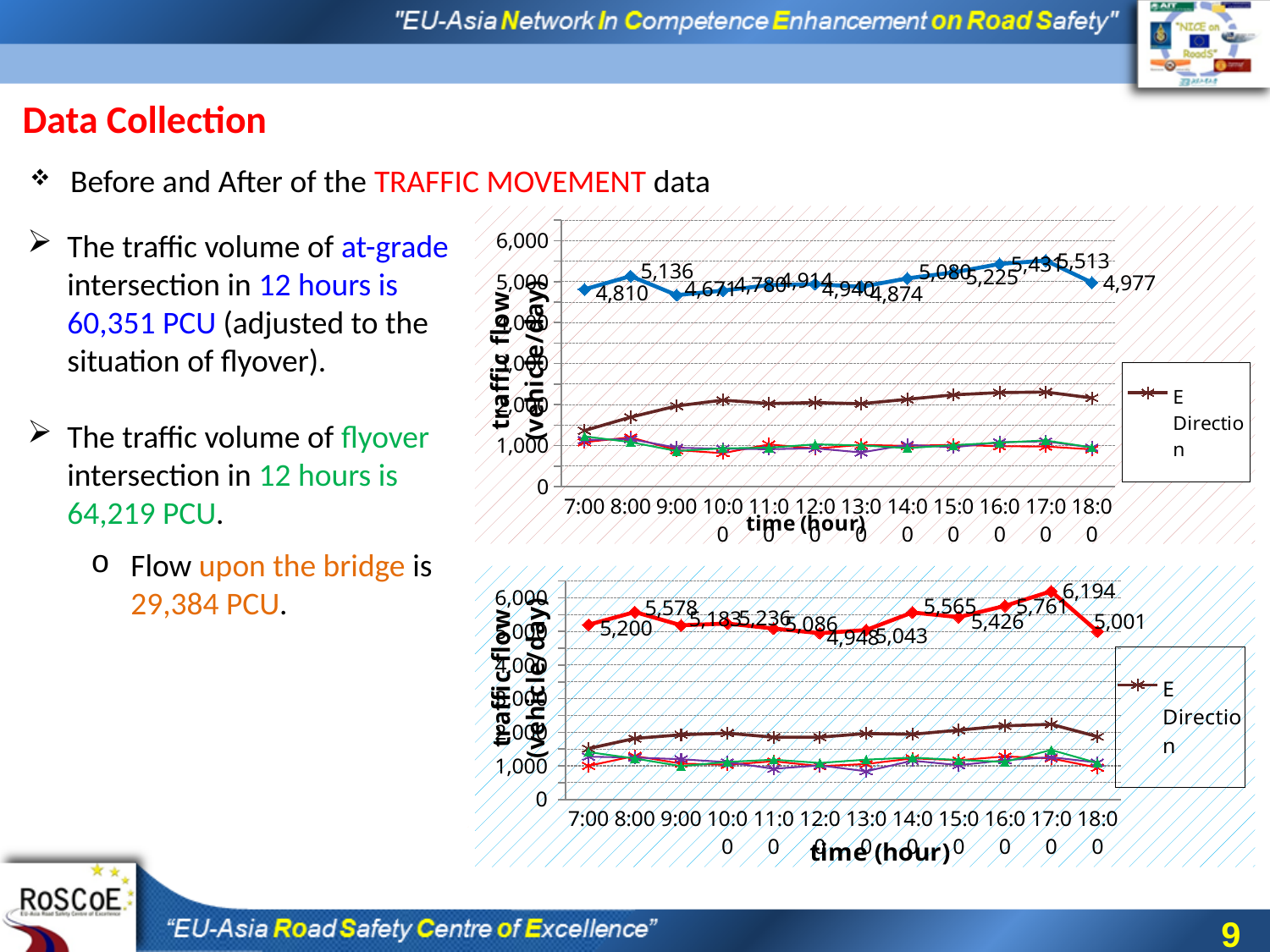
How many time points are shown on the x axis of the bottom chart? 12 In the top chart, what is the highest labelled value on the top line? 5,513 In the top chart, at which hour does the top line reach its highest labelled value? 17:00 In the bottom chart, what is the labelled value of the top line at 7:00? 5,200 In the bottom chart, what is the lowest labelled value on the top line? 4,948 In the bottom chart, which is larger for the top line: the value at 7:00 or the value at 8:00? 8:00 What type of chart is the top chart on the slide? Line chart In the top chart, what is the labelled value of the top line at 8:00? 5,136 In the top chart, what is the labelled value of the top line at 7:00? 4,810 In the bottom chart, what is the difference between the top line's values at 17:00 and 18:00? 1,193 In the top chart, what is the difference between the top line's values at 17:00 and 7:00? 703 In the bottom chart, what is the highest labelled value on the top line? 6,194